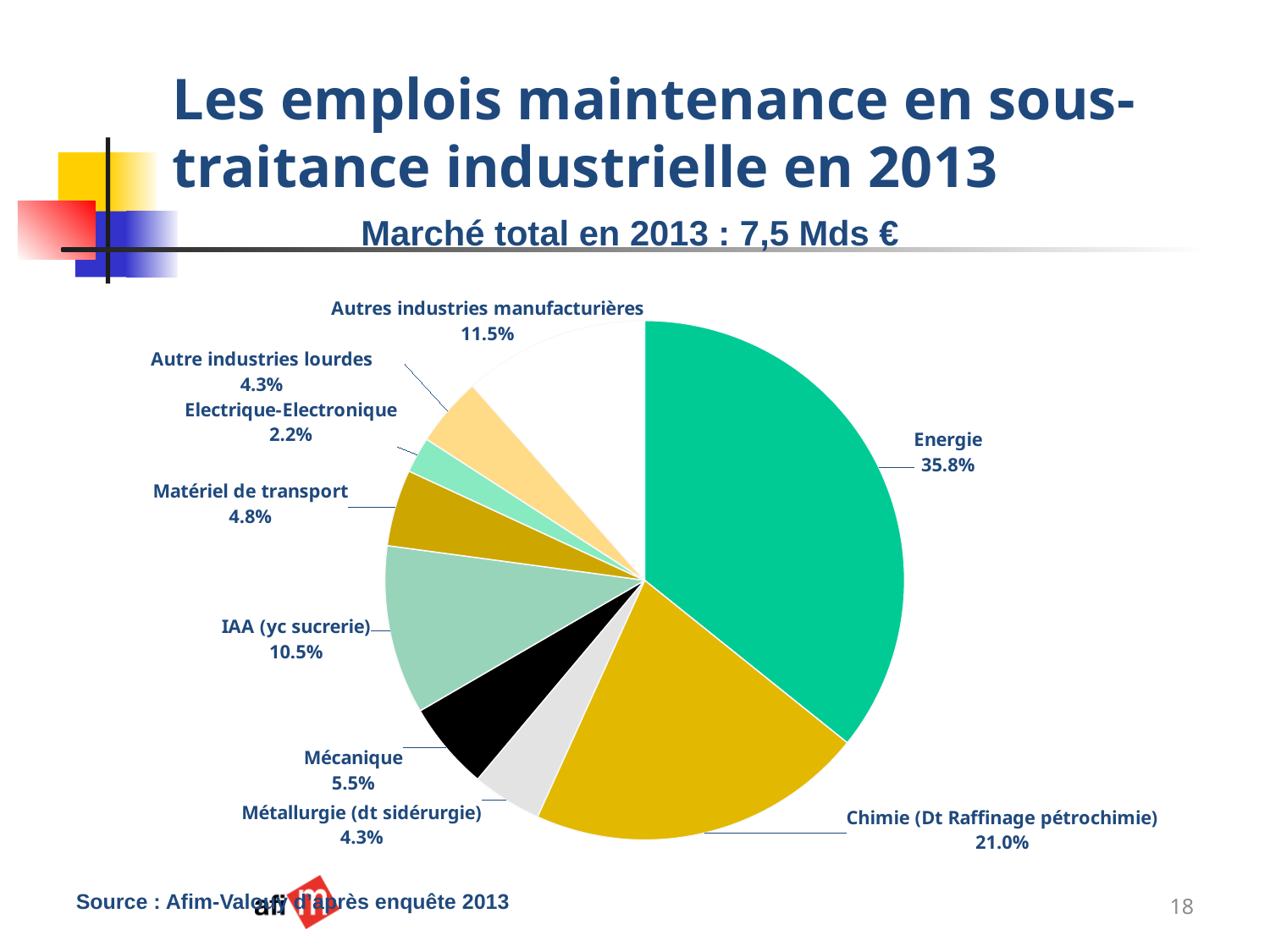
Which is larger, the share for Mécanique or the share for Matériel de transport? Mécanique What total market value for 2013 is stated above the chart? 7,5 Mds € Which category has the smallest share of the pie? Electrique-Electronique What is the value for Electrique-Electronique? 2.2% What is the difference in percentage points between Autres industries manufacturières and IAA (yc sucrerie)? 1.0 What is the value shown for Chimie (Dt Raffinage pétrochimie)? 21.0% What share of the pie does Energie represent? 35.8% What kind of chart is shown on the slide? Pie chart How many categories are shown in the pie chart? 9 What percentage is shown for IAA (yc sucrerie)? 10.5% Which category has the largest share of the pie? Energie What is the difference in percentage points between Energie and Chimie (Dt Raffinage pétrochimie)? 14.8